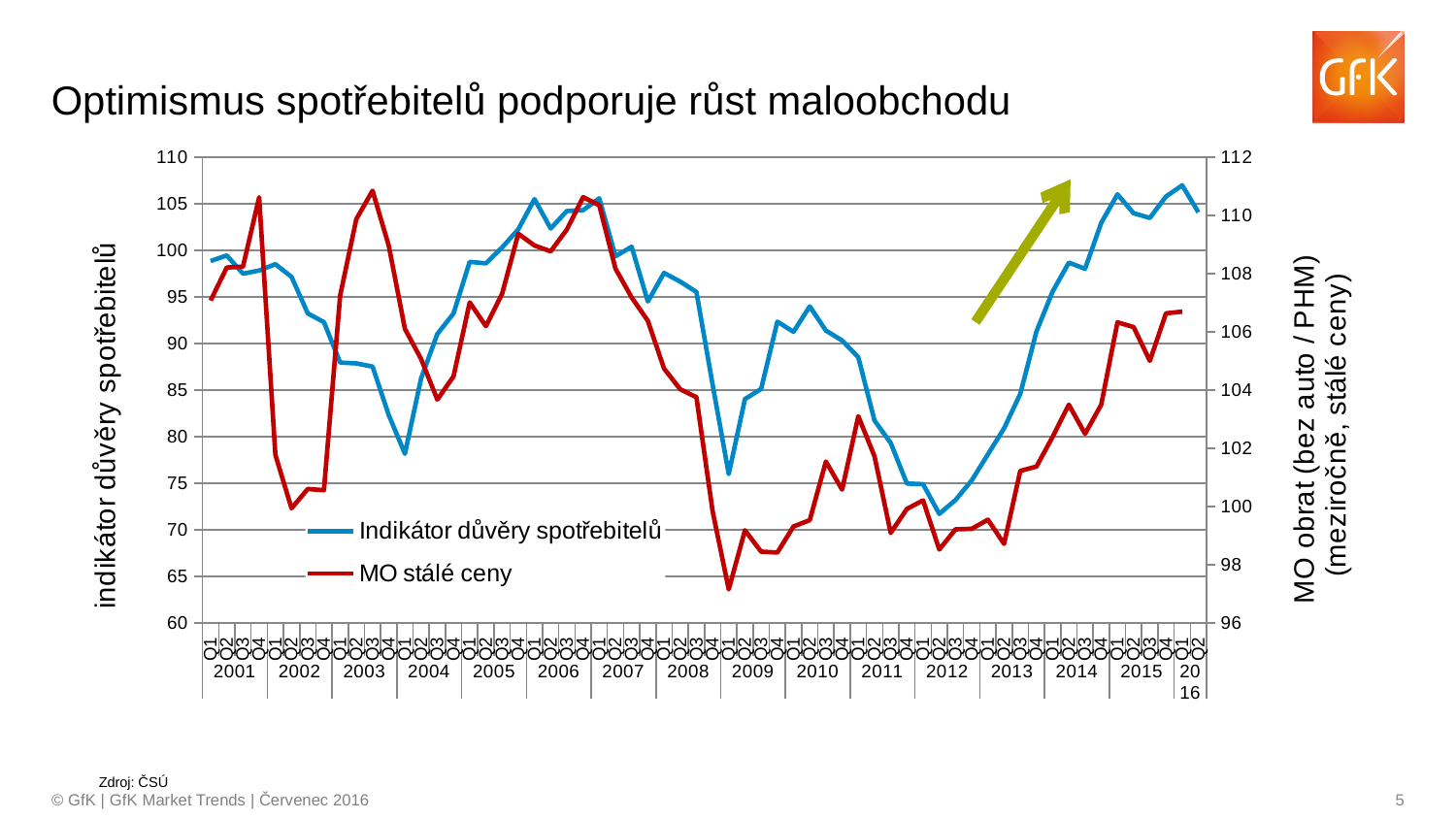
What are the two series named in the legend? Indikátor důvěry spotřebitelů; MO stálé ceny Is the value of MO stálé ceny in 2009 Q1 greater or less than 98? less In which year and quarter does the Indikátor důvěry spotřebitelů line reach its lowest point? 2012 Q2 In which year and quarter does the MO stálé ceny line reach its lowest point? 2009 Q1 What kind of chart is shown on the slide? line chart How many year labels appear along the x axis? 16 Is the value of Indikátor důvěry spotřebitelů in 2009 Q1 greater or less than 80? less How many series does the legend list? 2 What is the title of the slide containing the chart? Optimismus spotřebitelů podporuje růst maloobchodu Does the Indikátor důvěry spotřebitelů line rise or fall between 2007 Q1 and 2009 Q1? fall Does the Indikátor důvěry spotřebitelů line rise or fall between 2012 Q2 and 2016 Q1? rise Is the value of Indikátor důvěry spotřebitelů in 2016 Q1 greater or less than 105? greater